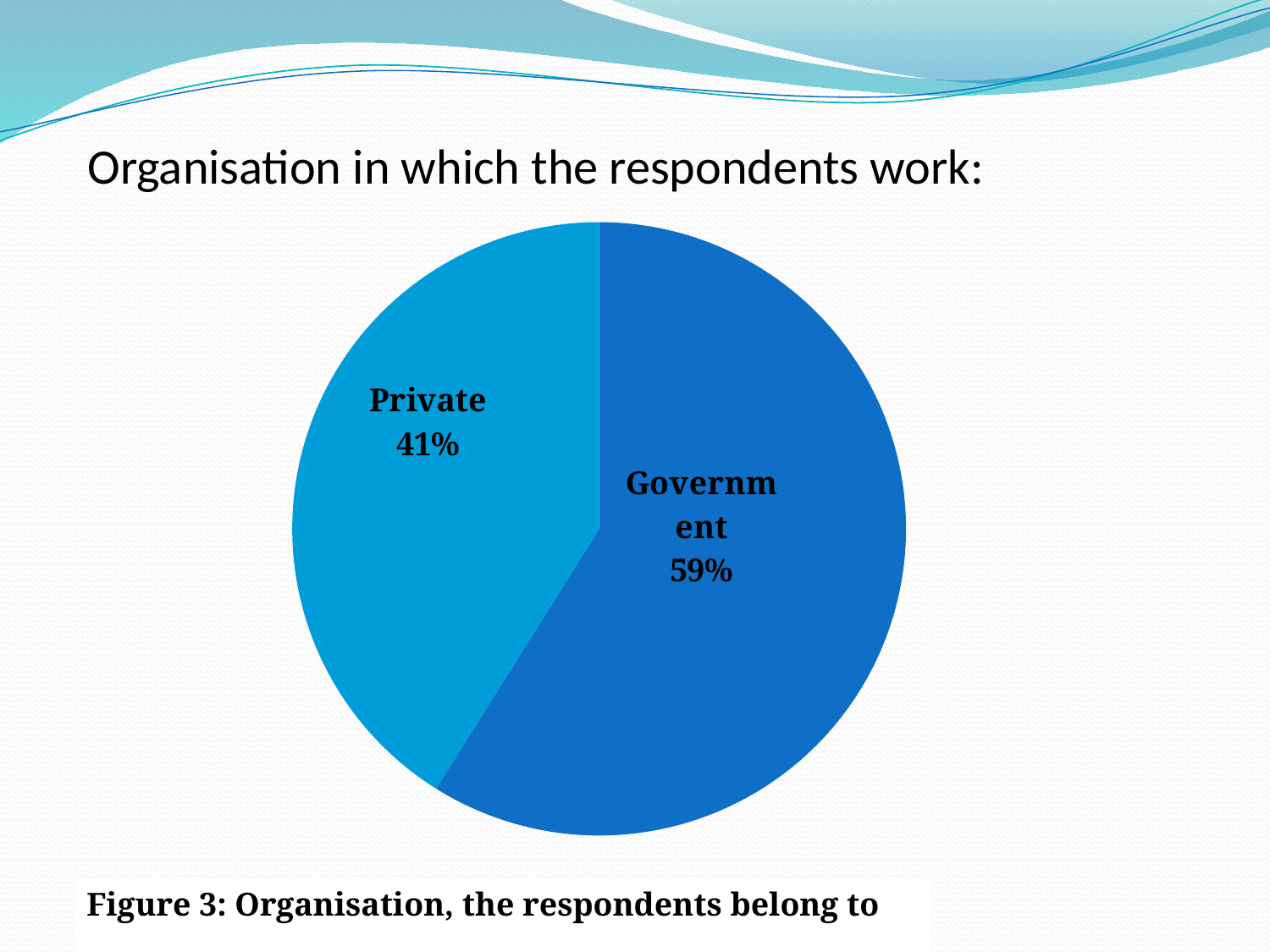
How many slices does the pie chart have? 2 What is the figure caption below the chart? Figure 3: Organisation, the respondents belong to Which is larger, the Government share or the Private share? Government What kind of chart is shown on the slide? pie chart What share of respondents work in Government organisations? 59% Which organisation type has the largest share of respondents? Government What is the total of the two slices shown in the pie chart? 100% What is the title shown above the chart? Organisation in which the respondents work: Which organisation type has the smallest share of respondents? Private What is the difference in percentage points between the Government and Private shares? 18 What share of respondents work in Private organisations? 41%